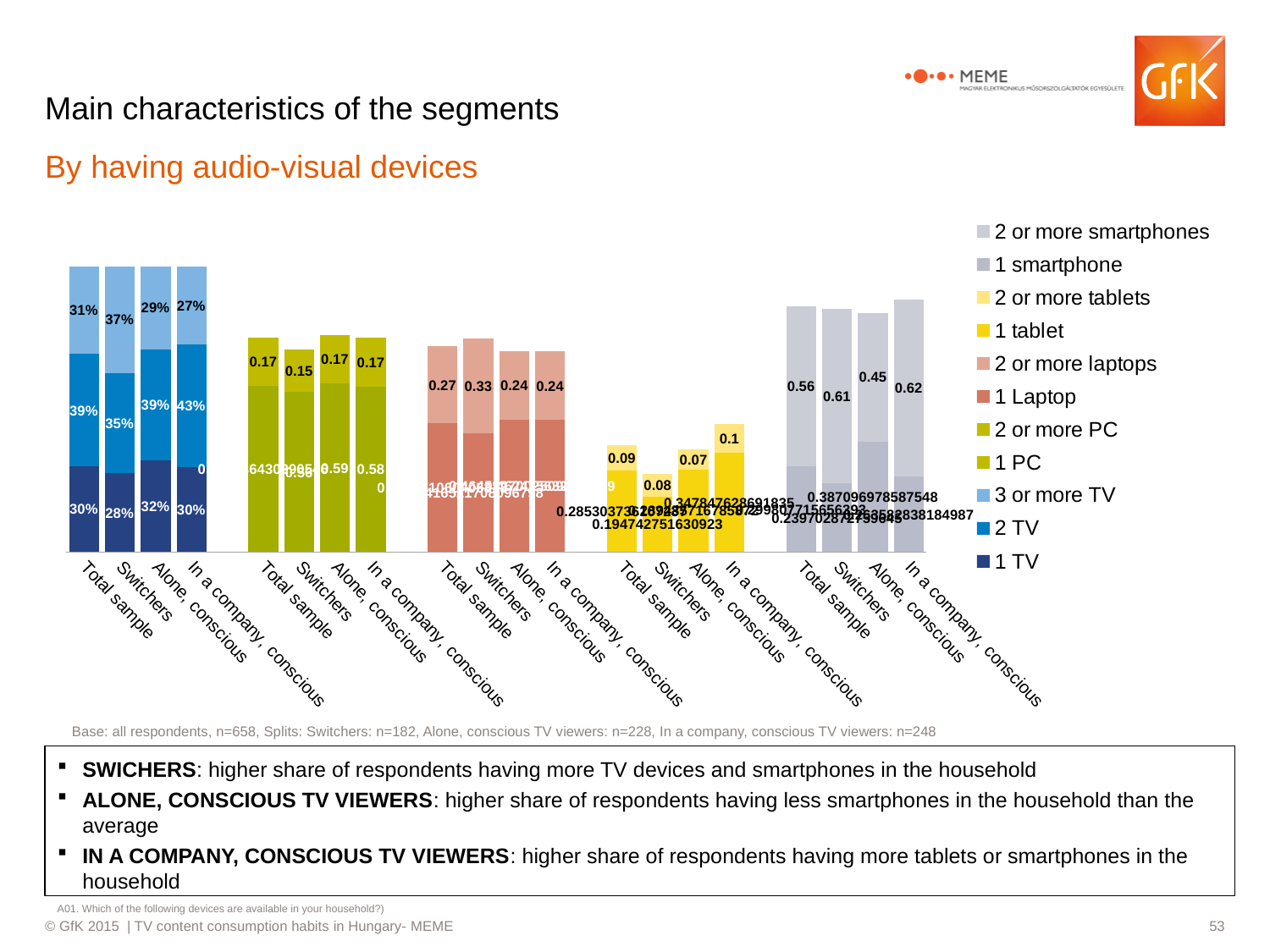
What is the value for '2 or more smartphones' in the 'Alone, conscious' segment? 0.45 How many series does the legend list? 11 What is the value for '2 or more PC' in the Switchers segment? 0.15 Which segment has the lowest value for '2 or more tablets'? Alone, conscious Which segment has the highest value for '2 or more smartphones'? In a company, conscious What is the difference between the '2 or more laptops' values for Switchers and Total sample? 0.06 What is the value for '2 TV' in the 'In a company, conscious' segment? 43% What kind of chart is shown on the slide? Stacked bar chart What is the value for '3 or more TV' in the Switchers segment? 37% What is the total of the TV stacked bar for the Switchers segment (1 TV, 2 TV and 3 or more TV)? 100% Which segment has the larger value for '1 TV': Switchers or 'Alone, conscious'? Alone, conscious How many segments (bars) are shown within each device group? 4